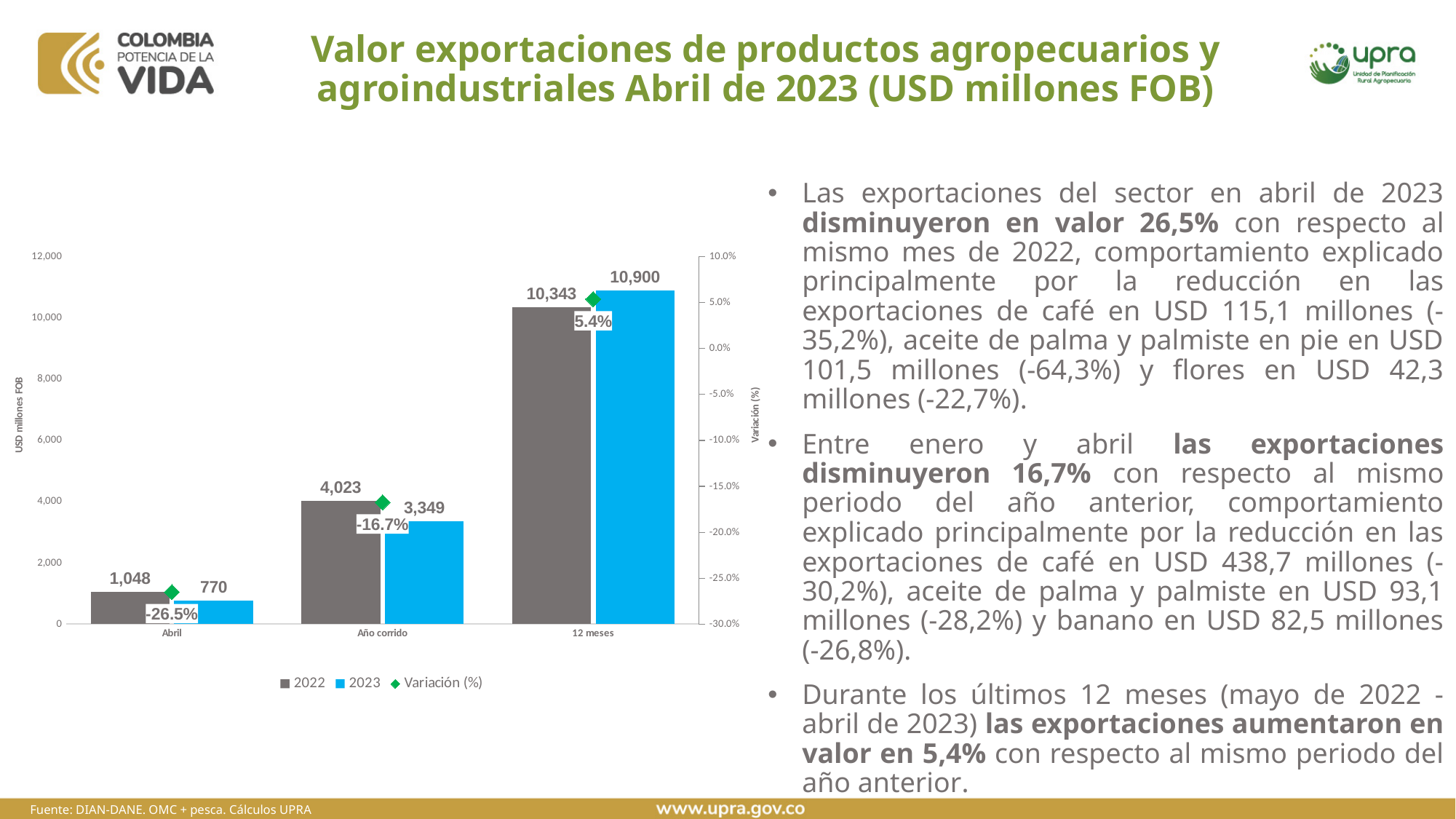
What is the Variación (%) value for 12 meses? 5.4% What is the difference between the 2022 and 2023 values for Año corrido? 674 For 12 meses, which is larger, the 2022 value or the 2023 value? 2023 What is the 2023 value for Año corrido? 3,349 Which category has the lowest 2022 value? Abril What is the Variación (%) value for Abril? -26.5% How many series does the legend list? 3 What is the 2023 value for 12 meses? 10,900 Which category has the highest 2023 value? 12 meses How many categories are shown on the x axis? 3 What is the 2022 value for Abril? 1,048 What kind of chart is shown on the slide? Bar chart with a marker series for Variación (%)